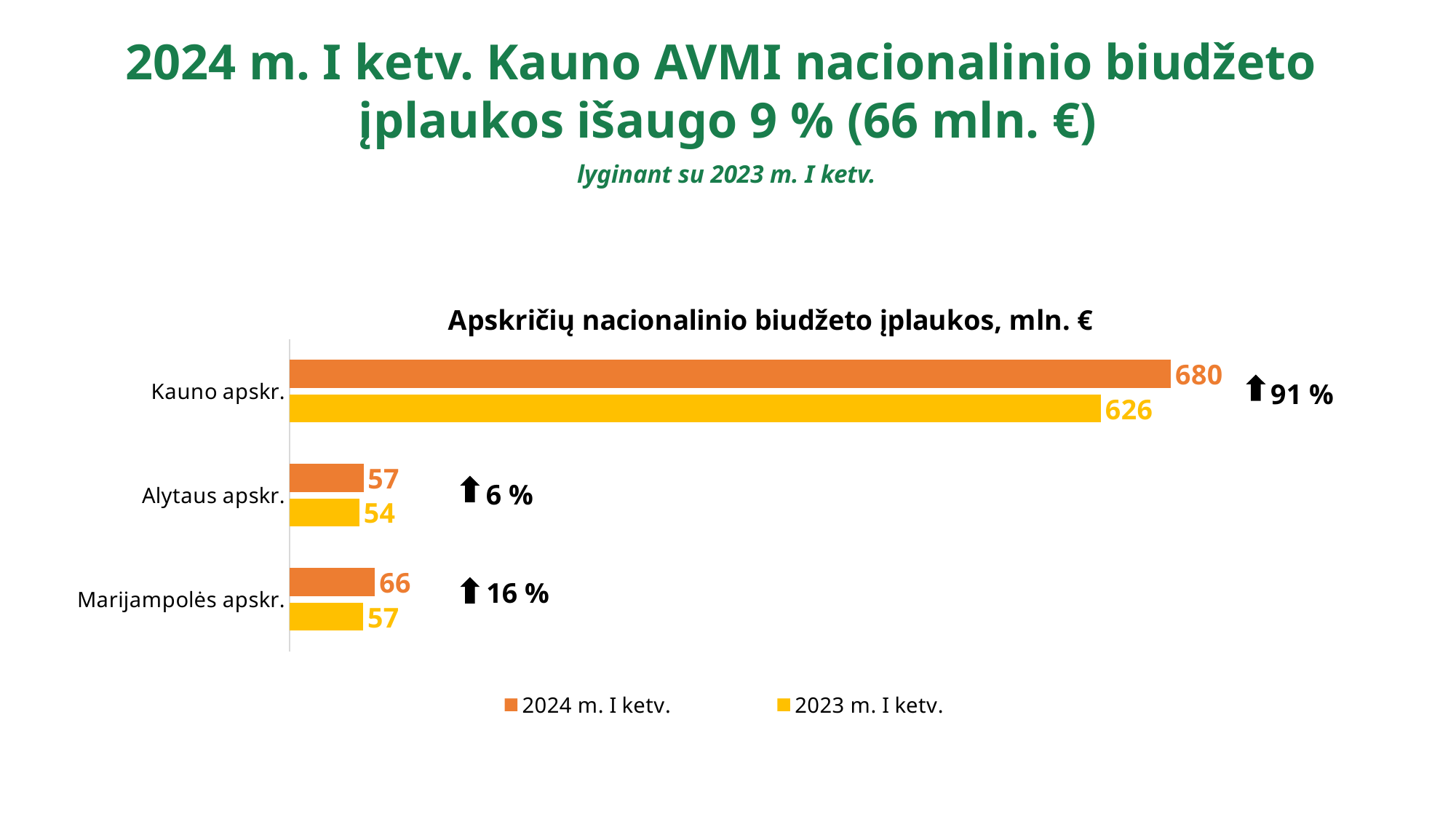
Which category has the highest value in the 2024 m. I ketv. series? Kauno apskr. What is the value for Alytaus apskr. in the 2023 m. I ketv. series? 54 How many series does the legend list? 2 What is the value for Kauno apskr. in the 2024 m. I ketv. series? 680 What is the value for Marijampolės apskr. in the 2024 m. I ketv. series? 66 What type of chart is shown on the slide? Bar chart What is the difference between the 2024 m. I ketv. and 2023 m. I ketv. values for Kauno apskr.? 54 How many categories are shown on the chart? 3 Which is larger: the 2024 m. I ketv. value for Marijampolės apskr. or the 2024 m. I ketv. value for Alytaus apskr.? Marijampolės apskr. What is the value for Kauno apskr. in the 2023 m. I ketv. series? 626 What is the difference between the 2024 m. I ketv. and 2023 m. I ketv. values for Marijampolės apskr.? 9 Which category has the lowest value in the 2023 m. I ketv. series? Alytaus apskr.